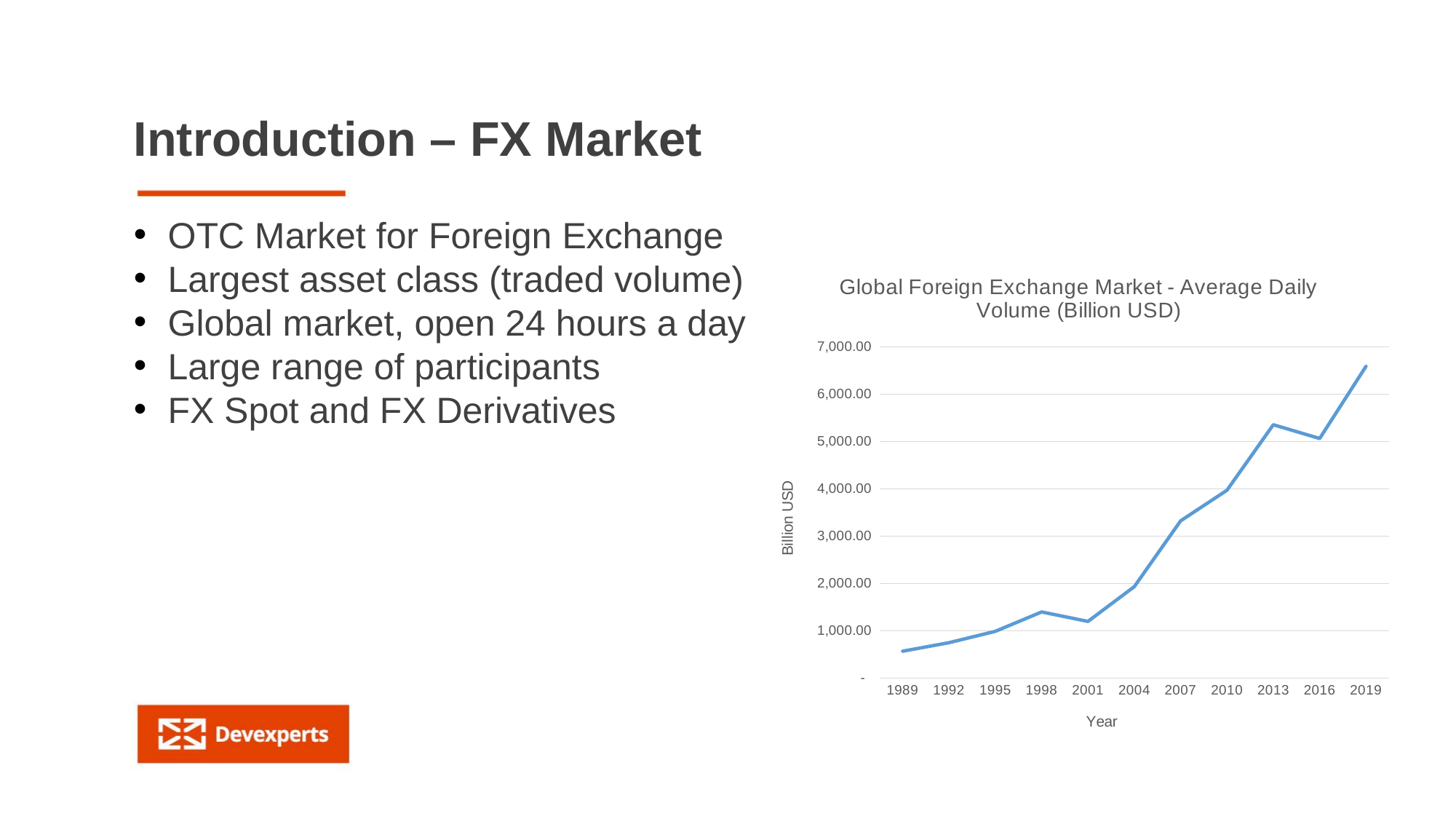
Which year has the lowest average daily volume in the chart? 1989 Overall, do the values in the chart rise or fall from 1989 to 2019? rise What is the label of the vertical axis of the chart? Billion USD How many years are plotted on the x axis of the chart? 11 Is the value for 1989 greater or less than 1,000.00? less What is the title of the chart? Global Foreign Exchange Market - Average Daily Volume (Billion USD) What kind of chart is shown on the slide? line chart Which year has the larger value, 2013 or 2016? 2013 Is the value for 2007 greater or less than 3,000.00? greater Is the value for 2016 greater or less than 6,000.00? less Which year has the highest average daily volume in the chart? 2019